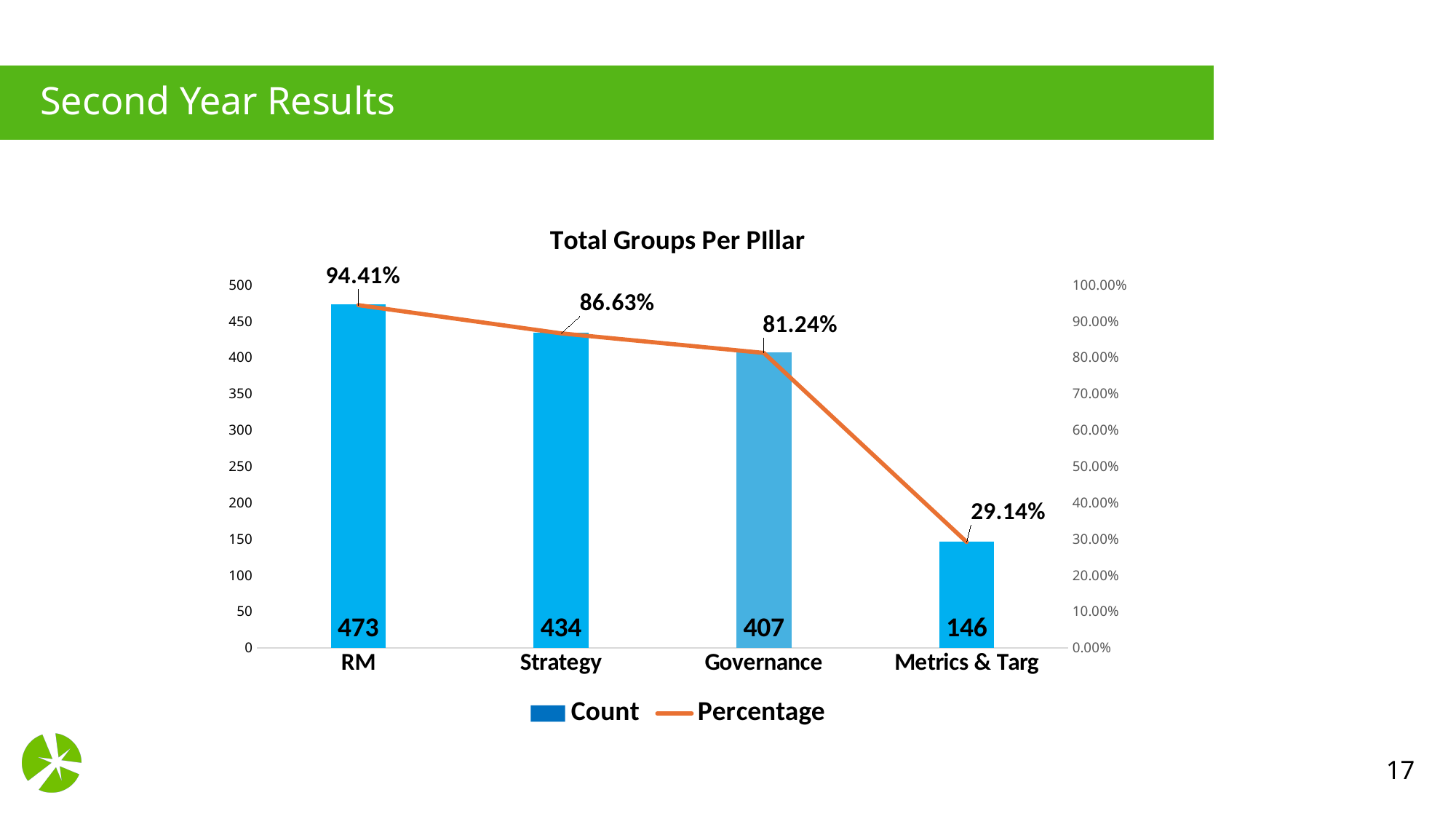
Which category has the lowest Percentage? Metrics & Targ Does the Percentage line rise or fall from RM to Metrics & Targ? Fall What is the difference in Count between Strategy and Governance? 27 What is the Count value for RM? 473 What kind of chart is used to show the Count series? Bar chart What is the Count value for Metrics & Targ? 146 Which has a higher Count, Strategy or Governance? Strategy How many series does the legend list? 2 Which category has the highest Count? RM What is the title of the chart? Total Groups Per PIllar How many categories are shown on the x axis? 4 What is the Percentage value for Governance? 81.24%